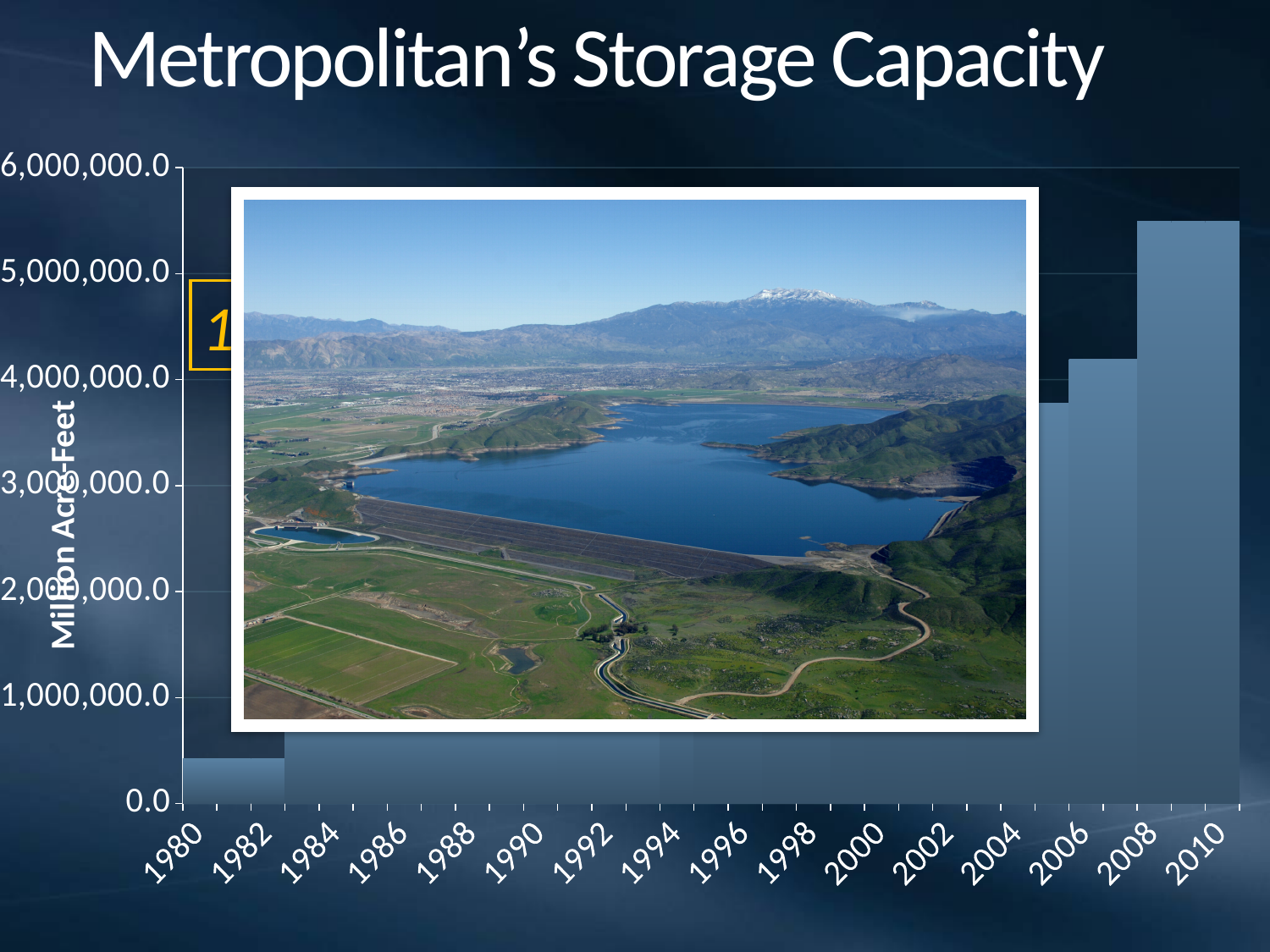
Is the value for 1980 greater or less than 1,000,000.0? less Is the value for 2006 greater or less than 4,000,000.0? greater Do the values generally rise or fall from 1980 to 2010? rise What is the title of the chart? Metropolitan's Storage Capacity Which is larger, the value for 2006 or the value for 2008? 2008 What is the label on the vertical axis of the chart? Million Acre-Feet Is the value for 2008 greater or less than 5,000,000.0? greater How many year labels are shown on the x axis? 16 What kind of chart is shown on the slide? bar chart Which is larger, the value for 1980 or the value for 2006? 2006